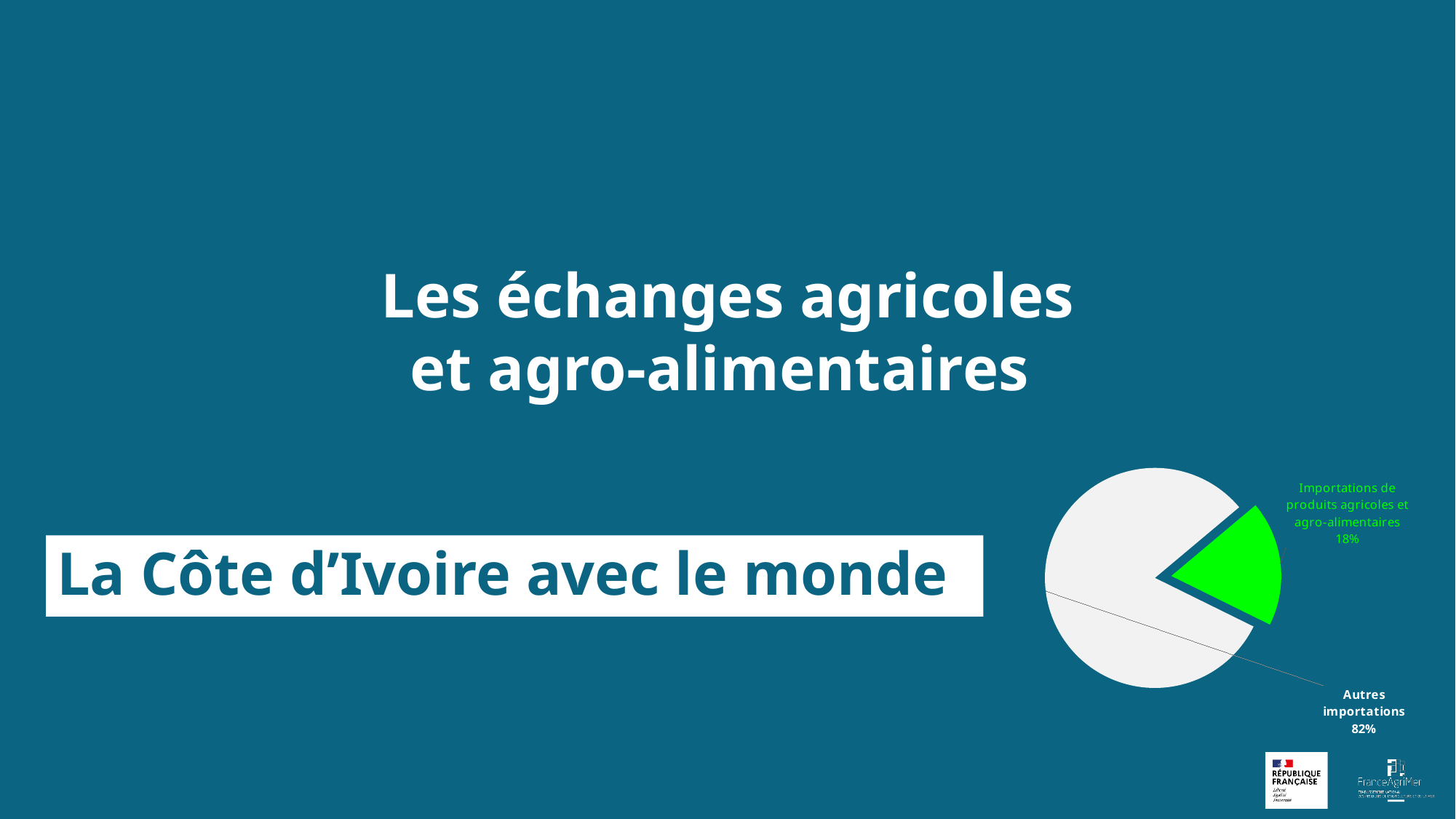
Which is larger, 'Autres importations' or 'Importations de produits agricoles et agro-alimentaires'? Autres importations Which slice of the pie is the largest? Autres importations What kind of chart is shown on the slide? pie chart What share of the pie is 'Importations de produits agricoles et agro-alimentaires'? 18% What is the difference in percentage points between 'Autres importations' and 'Importations de produits agricoles et agro-alimentaires'? 64 What share of the pie is 'Autres importations'? 82% What colour is the 'Importations de produits agricoles et agro-alimentaires' slice? green What is the total of the two pie slices' percentages? 100% How many slices does the pie chart have? 2 Which slice of the pie is the smallest? Importations de produits agricoles et agro-alimentaires